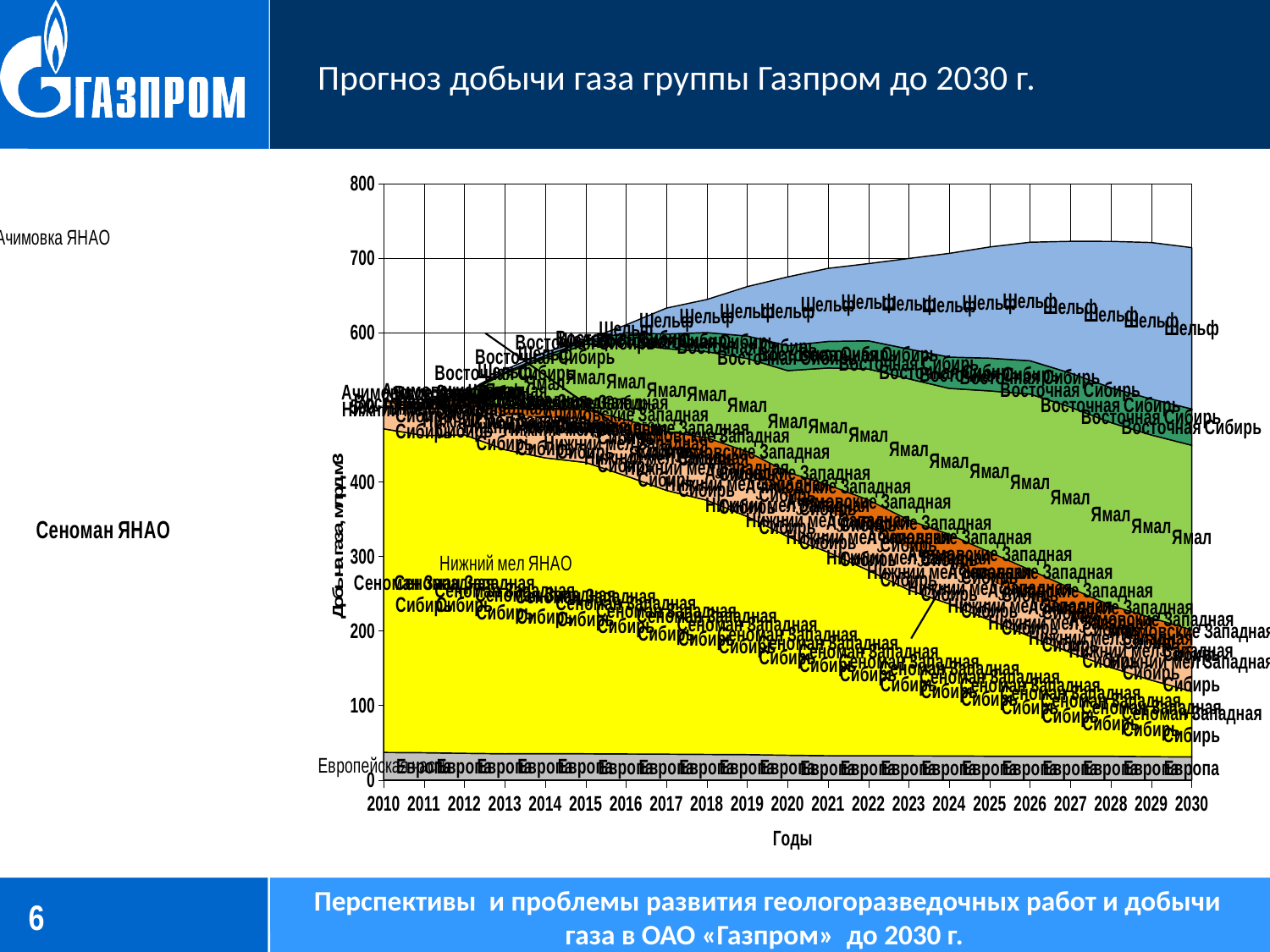
What is the highest value marked on the y axis of the chart? 800 Does the Сеноман ЯНАО (yellow) area in the chart grow or shrink from 2010 to 2030? Shrinks What is the first year shown on the x axis of the chart? 2010 What is the title of the chart on the slide? Прогноз добычи газа группы Газпром до 2030 г. Is the total gas production in 2030 greater or less than 600? greater What is the label of the x axis of the chart? Годы Is the total gas production in 2020 greater or less than 600? greater What is the last year shown on the x axis of the chart? 2030 Does the total gas production in the chart rise or fall from 2010 to 2030? Rises What kind of chart is shown on the slide? Stacked area chart How many years are shown along the x axis of the chart? 21 Is the total gas production in 2010 greater or less than 600? less